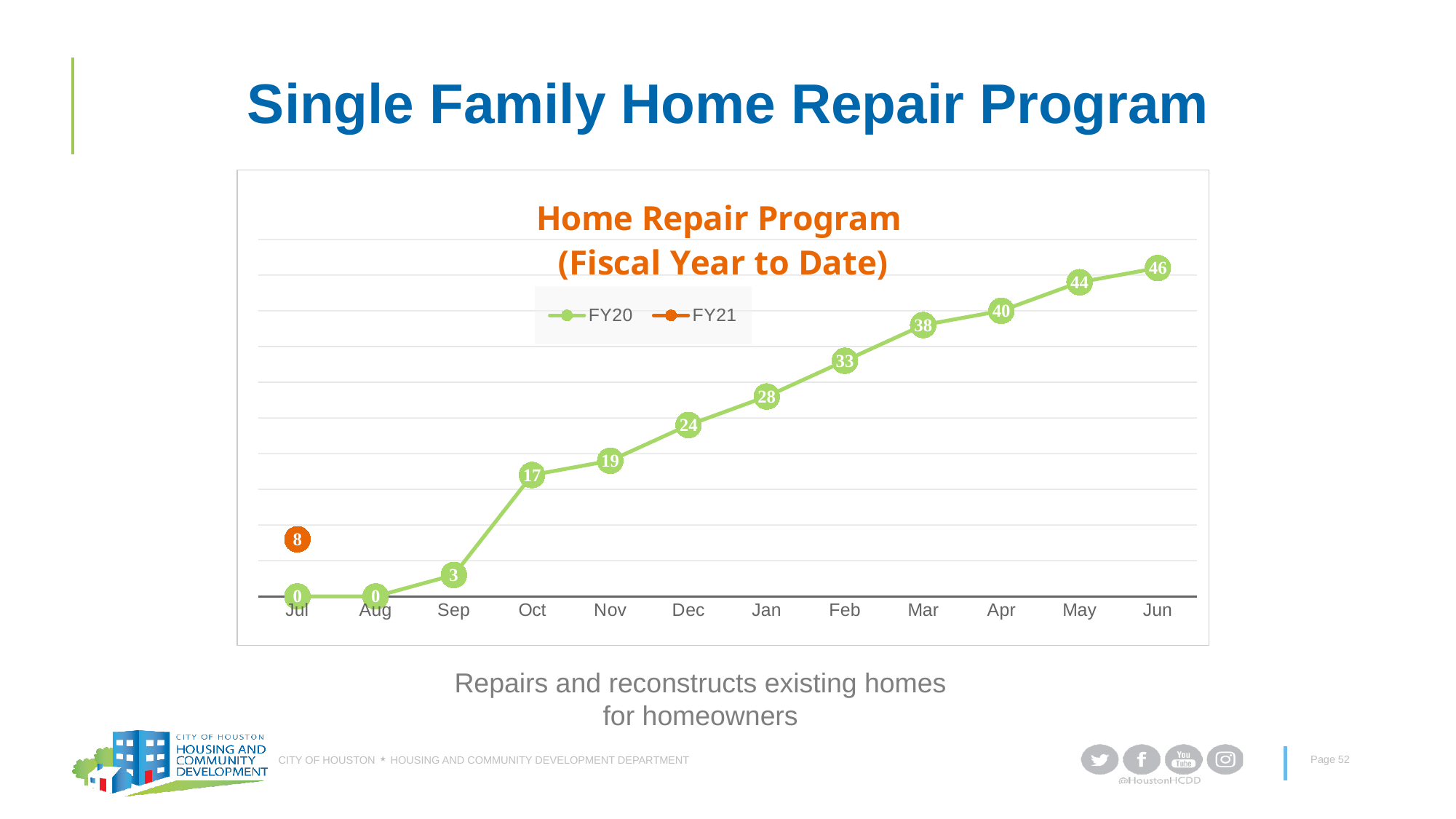
Do the FY20 values rise or fall from Jul to Jun? Rise Which month has the highest FY20 value? Jun How many series does the legend list? 2 Which is larger, the FY21 value for Jul or the FY20 value for Sep? FY21 value for Jul How many months are shown on the x axis? 12 What is the FY20 value for Jun? 46 What colour is the FY21 series? Orange What kind of chart is this? Line chart What is the title of the chart? Home Repair Program (Fiscal Year to Date) What is the FY20 value for Oct? 17 What is the FY21 value for Jul? 8 What is the difference between the FY20 values for Mar and Feb? 5